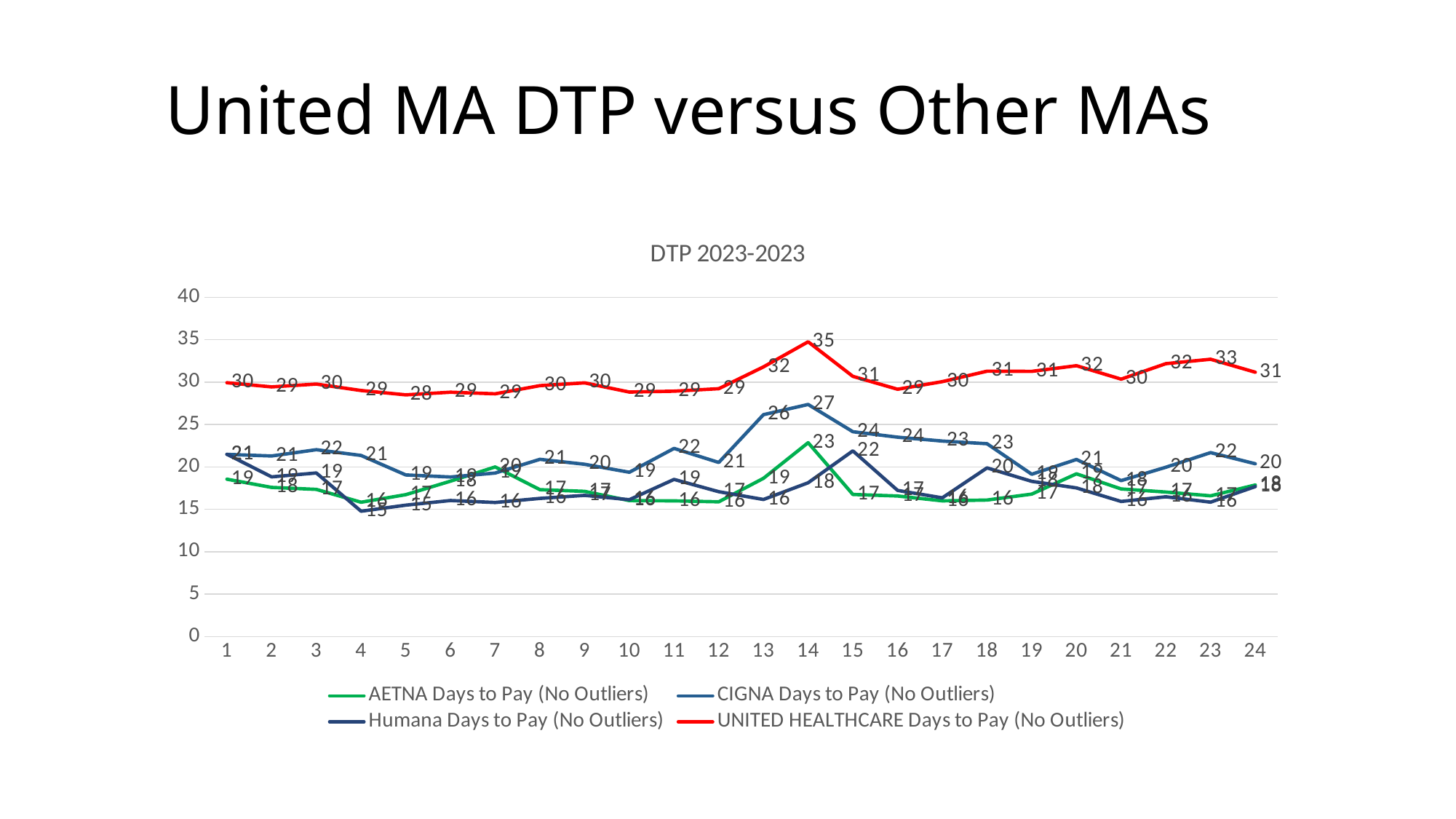
At which x-axis point does the UNITED HEALTHCARE Days to Pay series reach its highest value? 14 What is the CIGNA Days to Pay value at point 14? 27 At point 14, which is larger: the AETNA Days to Pay value or the Humana Days to Pay value? AETNA Days to Pay What is the title of the chart? DTP 2023-2023 How many points are plotted along the x axis for each series? 24 What is the UNITED HEALTHCARE Days to Pay value at point 24? 31 How many series does the legend list? 4 What kind of chart is shown on the slide? line chart What is the difference between the UNITED HEALTHCARE and CIGNA Days to Pay values at point 14? 8 Is the UNITED HEALTHCARE Days to Pay value at point 1 greater or less than 25? greater What is the lowest value of the UNITED HEALTHCARE Days to Pay series? 28 What is the UNITED HEALTHCARE Days to Pay value at point 14? 35